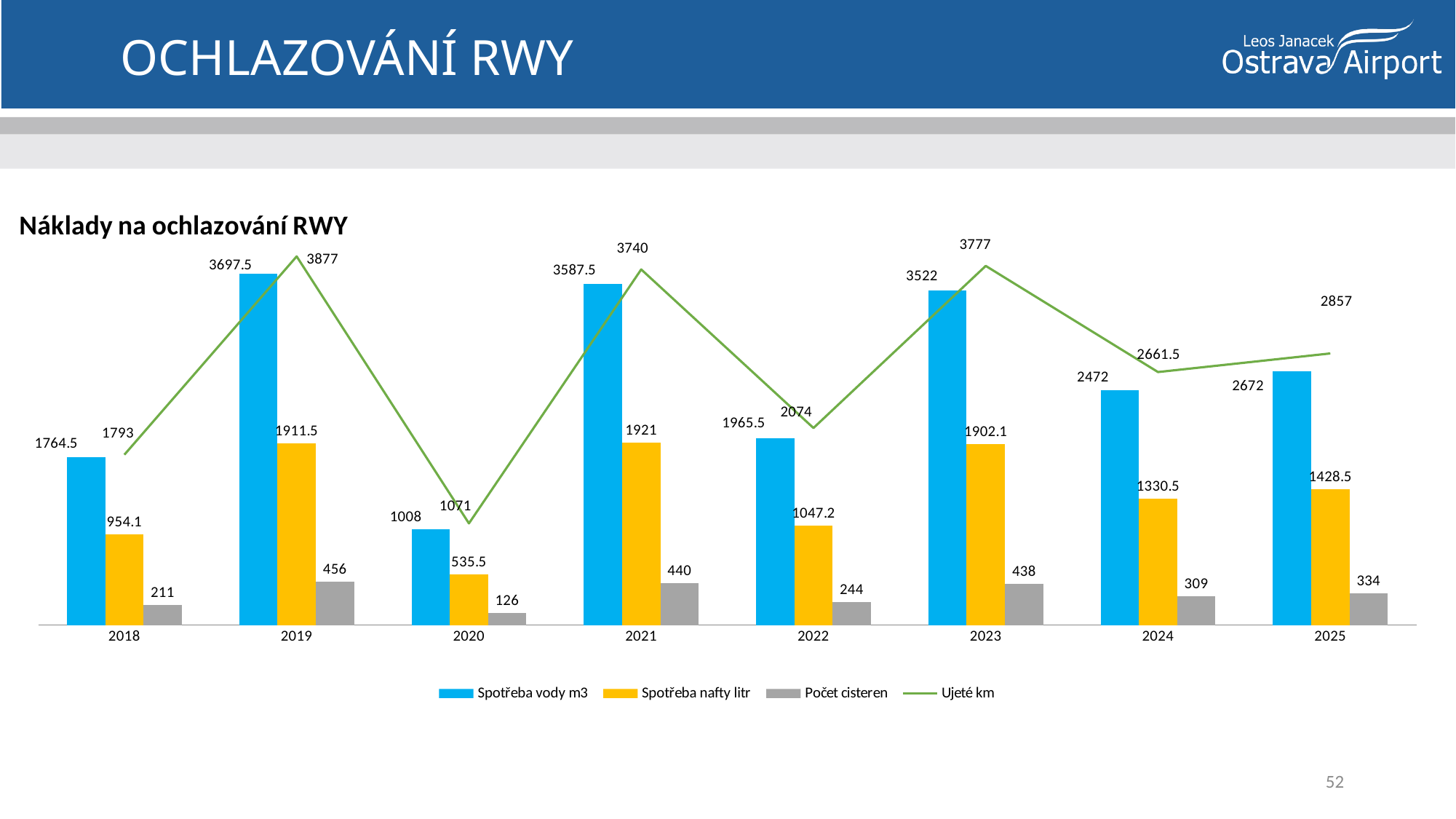
Which year has the lowest value of Spotřeba vody m3? 2020 What kind of chart is shown on the slide? Combined bar and line chart Which is larger: Spotřeba nafty litr in 2021 or in 2023? 2021 How many series does the legend list? 4 Which year has the highest value of Ujeté km? 2019 What is the value of Počet cisteren for 2024? 309 What is the value of Ujeté km for 2025? 2857 What is the value of Spotřeba nafty litr for 2022? 1047.2 Does Spotřeba vody m3 rise or fall from 2023 to 2024? fall What is the difference between Počet cisteren in 2019 and in 2020? 330 What is the value of Spotřeba vody m3 for 2019? 3697.5 How many years are shown on the x axis? 8